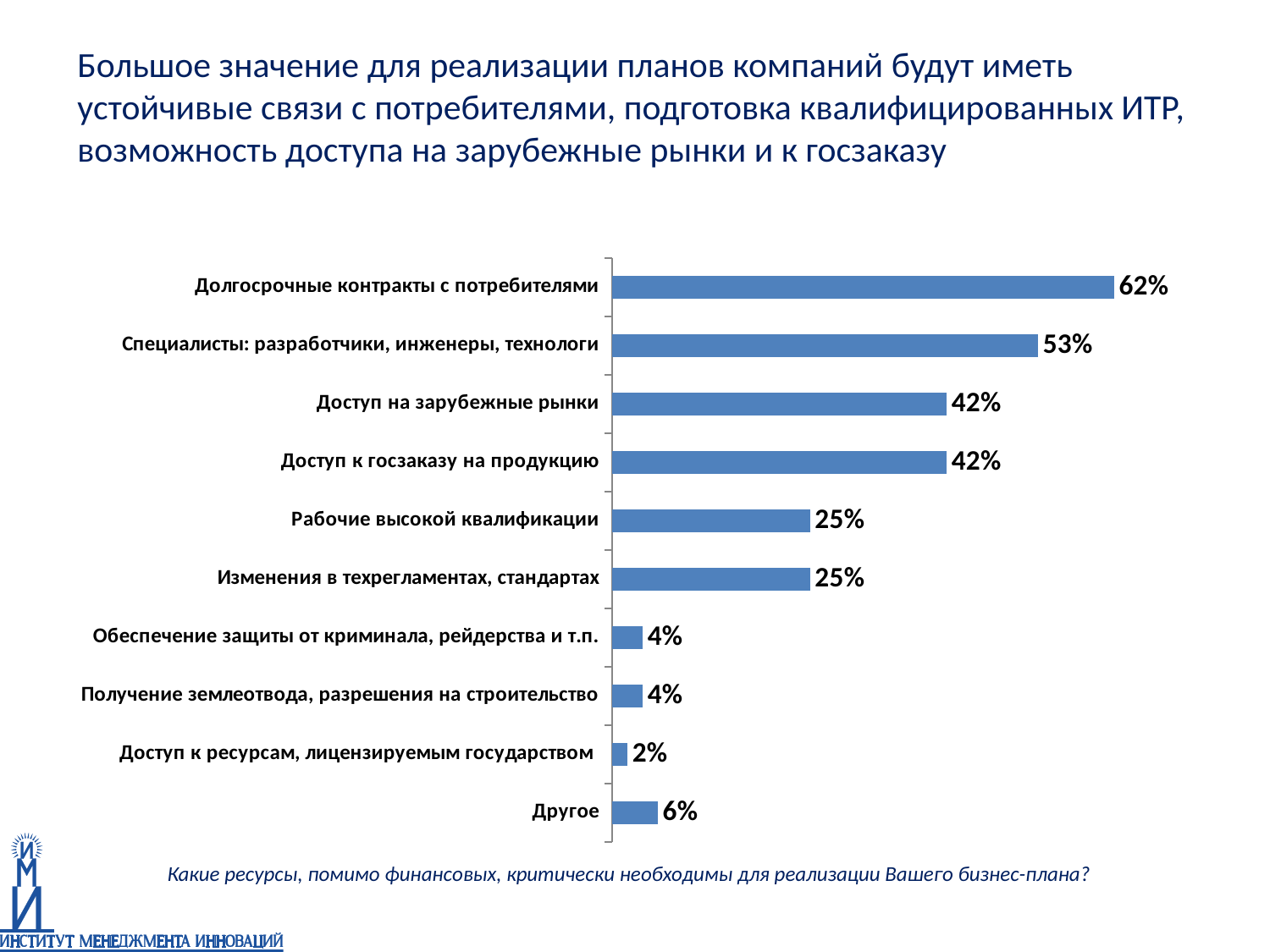
Which is larger: the value for "Другое" or the value for "Получение землеотвода, разрешения на строительство"? Другое What question is written in italics below the chart? Какие ресурсы, помимо финансовых, критически необходимы для реализации Вашего бизнес-плана? What kind of chart is shown on the slide? Bar chart What is the difference between the values for "Доступ на зарубежные рынки" and "Изменения в техрегламентах, стандартах"? 17% Which category has the highest value? Долгосрочные контракты с потребителями What is the value for "Рабочие высокой квалификации"? 25% How many categories are shown in the chart? 10 What is the difference between the values for "Долгосрочные контракты с потребителями" and "Специалисты: разработчики, инженеры, технологи"? 9% What is the value for "Долгосрочные контракты с потребителями"? 62% What is the value for "Доступ к ресурсам, лицензируемым государством"? 2% What is the value for "Другое"? 6% Which category has the lowest value? Доступ к ресурсам, лицензируемым государством